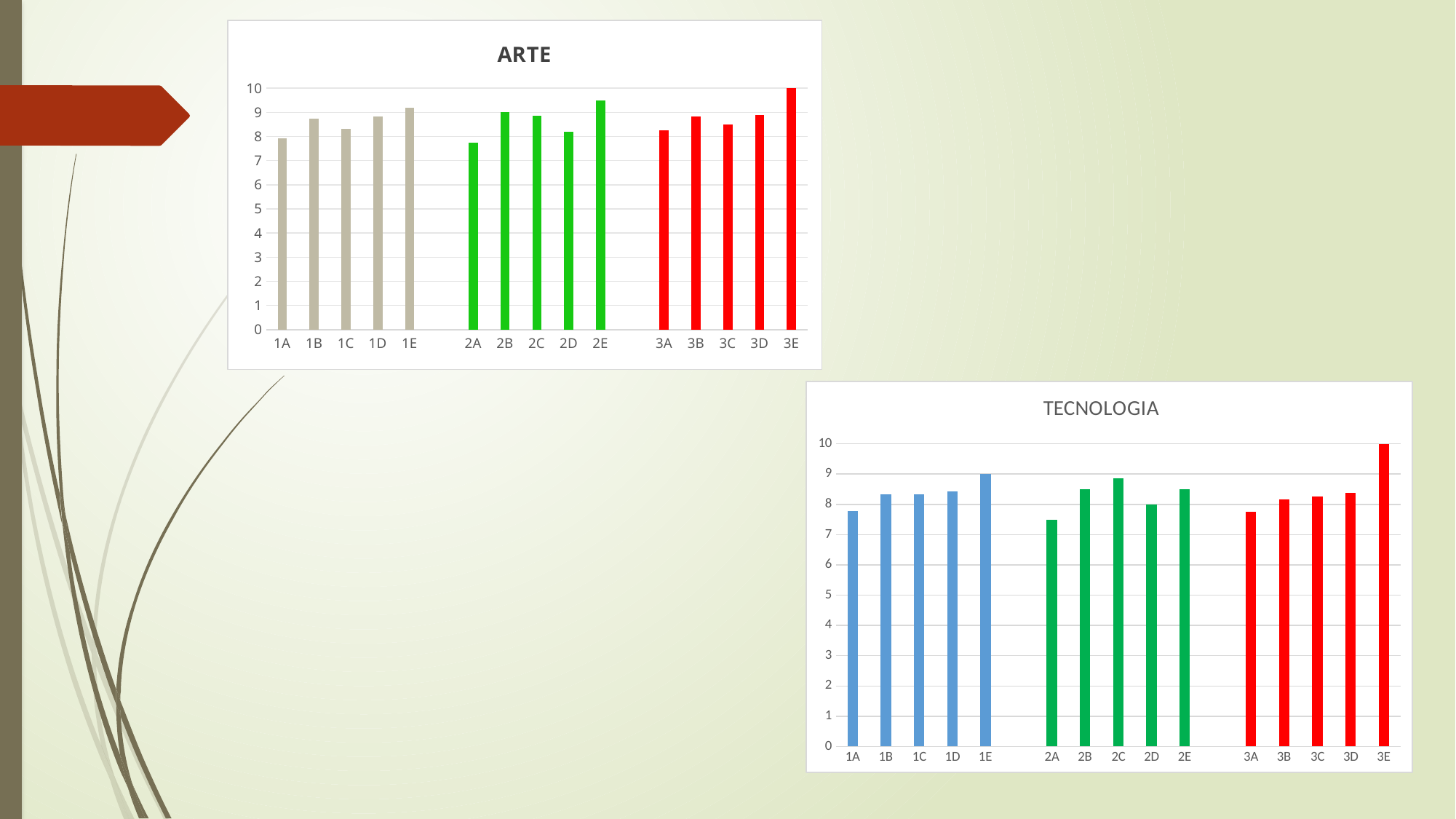
In the ARTE chart, which category has the highest value? 3E In the ARTE chart, is the value for 2A greater or less than 8? less In the ARTE chart, what is the value for 3E? 10 What kind of chart is the ARTE chart? bar chart In the TECNOLOGIA chart, is the value for 2A greater or less than 8? less How many categories are shown on the x axis of the TECNOLOGIA chart? 15 What colour are the bars for 3A to 3E in the TECNOLOGIA chart? red In the TECNOLOGIA chart, which category has the highest value? 3E In the TECNOLOGIA chart, what is the value for 1E? 9 In the ARTE chart, is the value for 1E greater or less than 9? greater In the ARTE chart, which category has the lowest value? 2A In the ARTE chart, which is larger, the value for 2D or the value for 2E? 2E